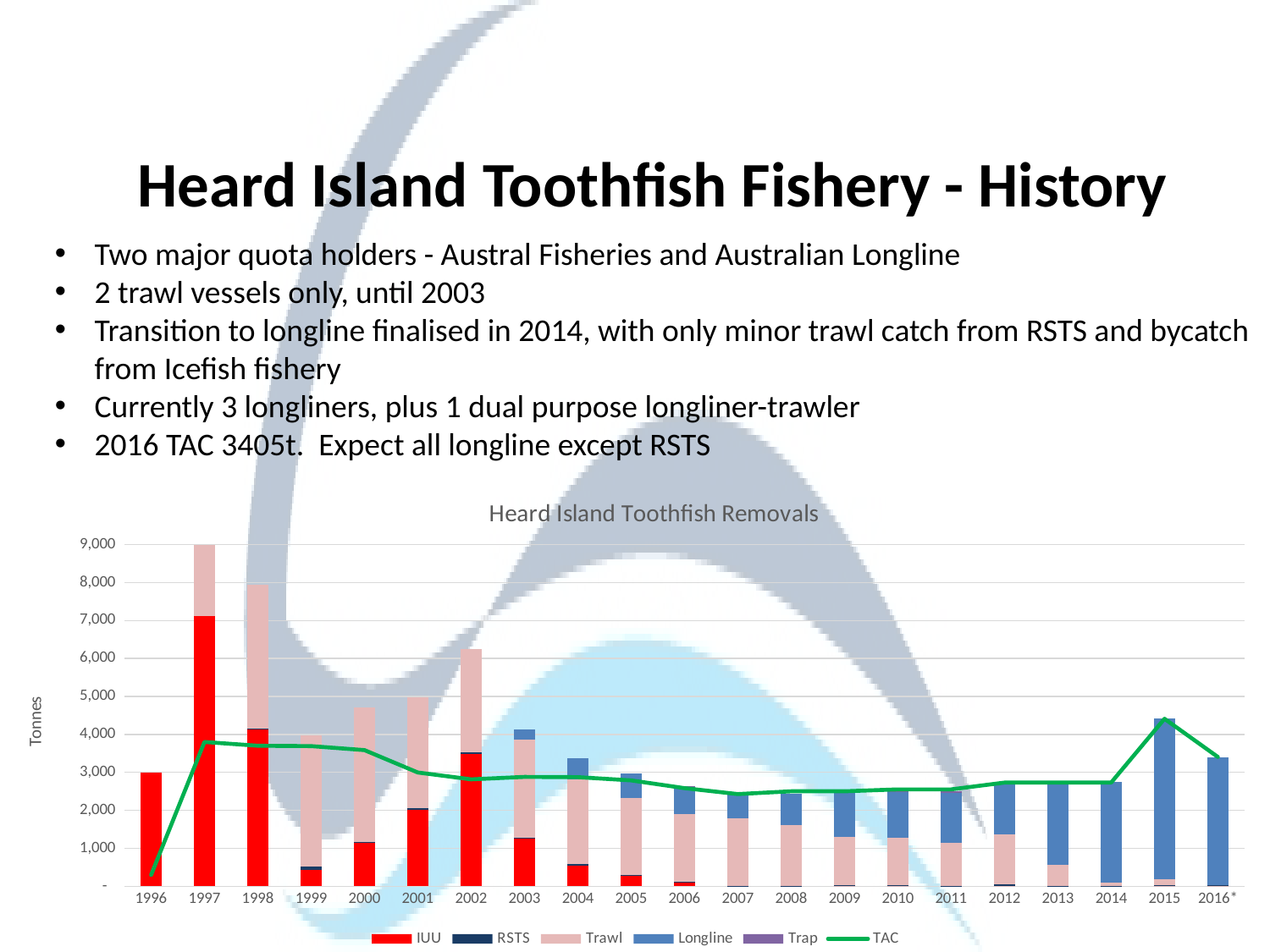
Which year has the tallest bar in the 'Heard Island Toothfish Removals' chart? 1997 What is the label on the y axis of the 'Heard Island Toothfish Removals' chart? Tonnes Is the total removals bar for 2015 greater or less than 4,000? greater Which year has the larger total removals bar, 2015 or 2016*? 2015 How many series does the legend of the 'Heard Island Toothfish Removals' chart list? 6 Is the total removals bar for 2000 greater or less than 4,000? greater What kind of chart is 'Heard Island Toothfish Removals'? Stacked bar chart with a line Does the TAC line rise or fall between 2014 and 2015? rise How many years are shown on the x axis of the 'Heard Island Toothfish Removals' chart? 21 Which year has the larger total removals bar, 1997 or 1998? 1997 Is the total removals bar for 1997 greater or less than 8,000? greater